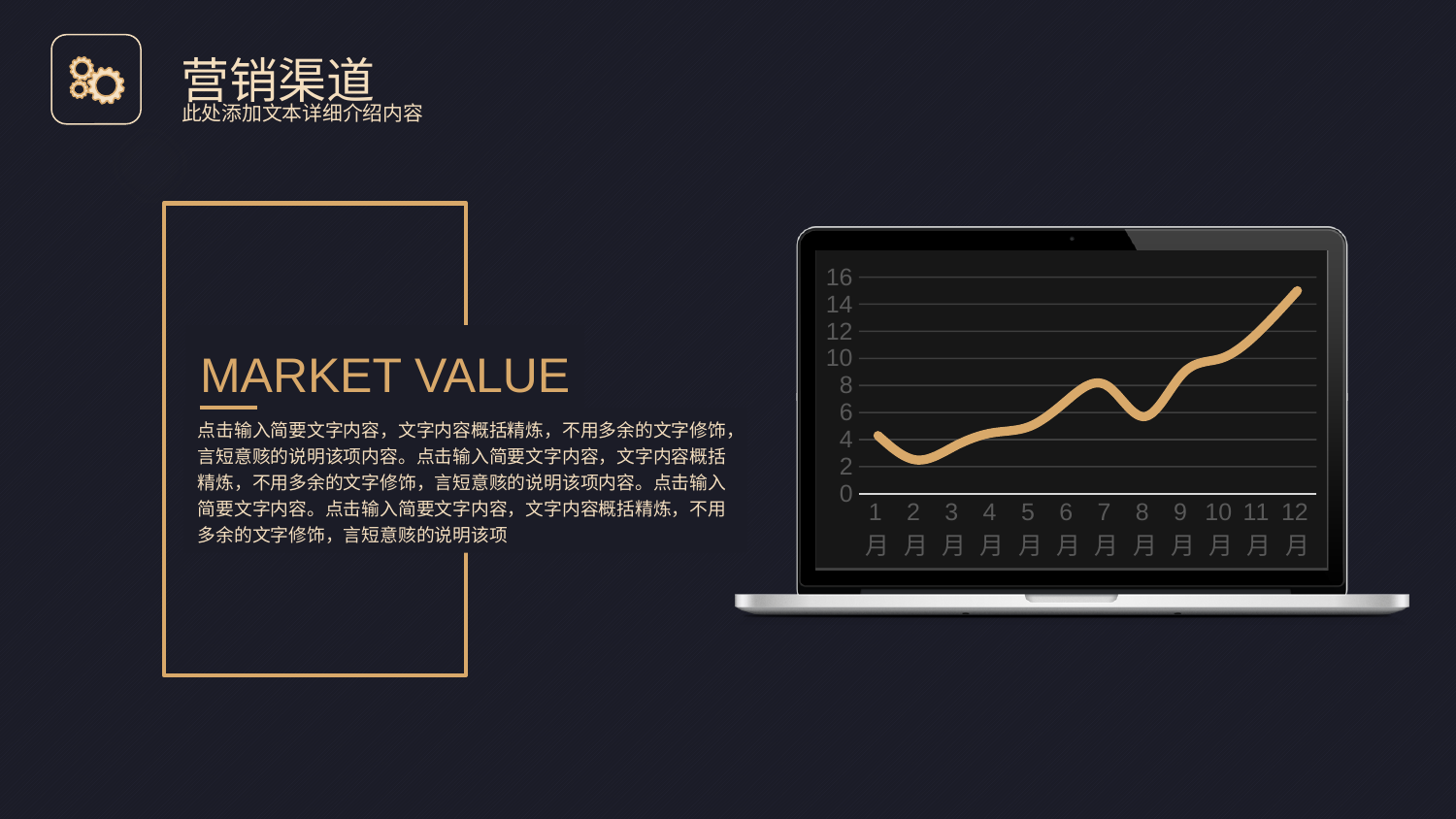
Is the value for 7月 greater or less than 6? greater Is the value for 12月 greater or less than 14? greater Which month has the highest value in the chart? 12月 Do the values generally rise or fall from 8月 to 12月? rise Is the value for 11月 greater or less than 10? greater Which month has the lowest value in the chart? 2月 What kind of chart is shown on the slide? line chart Which is larger, the value for 7月 or the value for 8月? 7月 What is the highest tick value shown on the y axis of the chart? 16 How many months are plotted along the x axis of the chart? 12